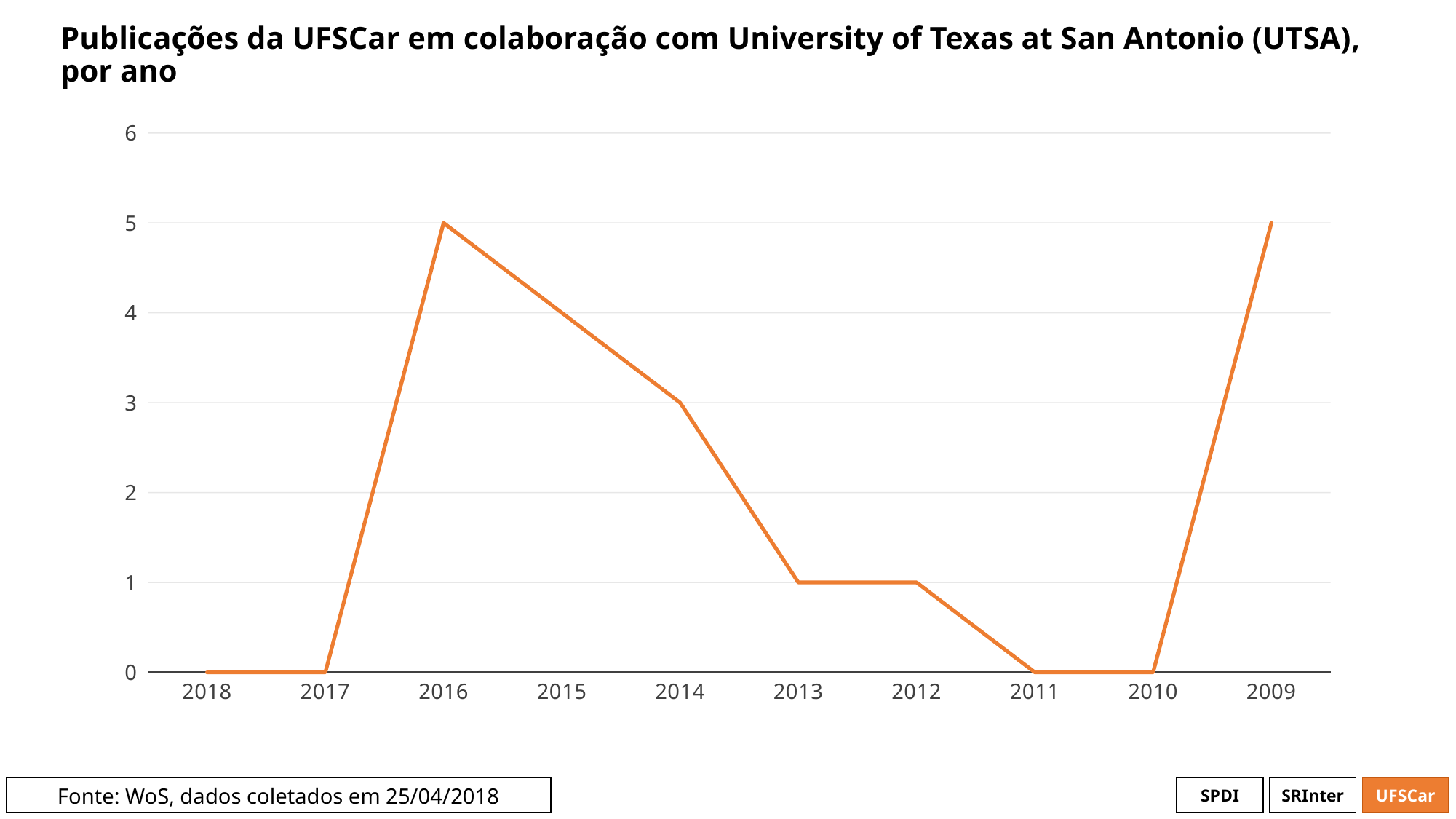
Is the value for 2014 greater or less than 2? greater What is the value for 2013? 1 What is the value for 2017? 0 What is the value for 2009? 5 Which is larger, the value for 2016 or the value for 2014? 2016 What is the difference between the value for 2016 and the value for 2014? 2 What is the value for 2014? 3 What type of chart is shown on the slide? line chart Do the values rise or fall along the x axis from 2016 to 2011? fall How many years are shown on the x axis? 10 What is the value for 2016? 5 What is the source cited at the bottom of the slide? WoS, dados coletados em 25/04/2018